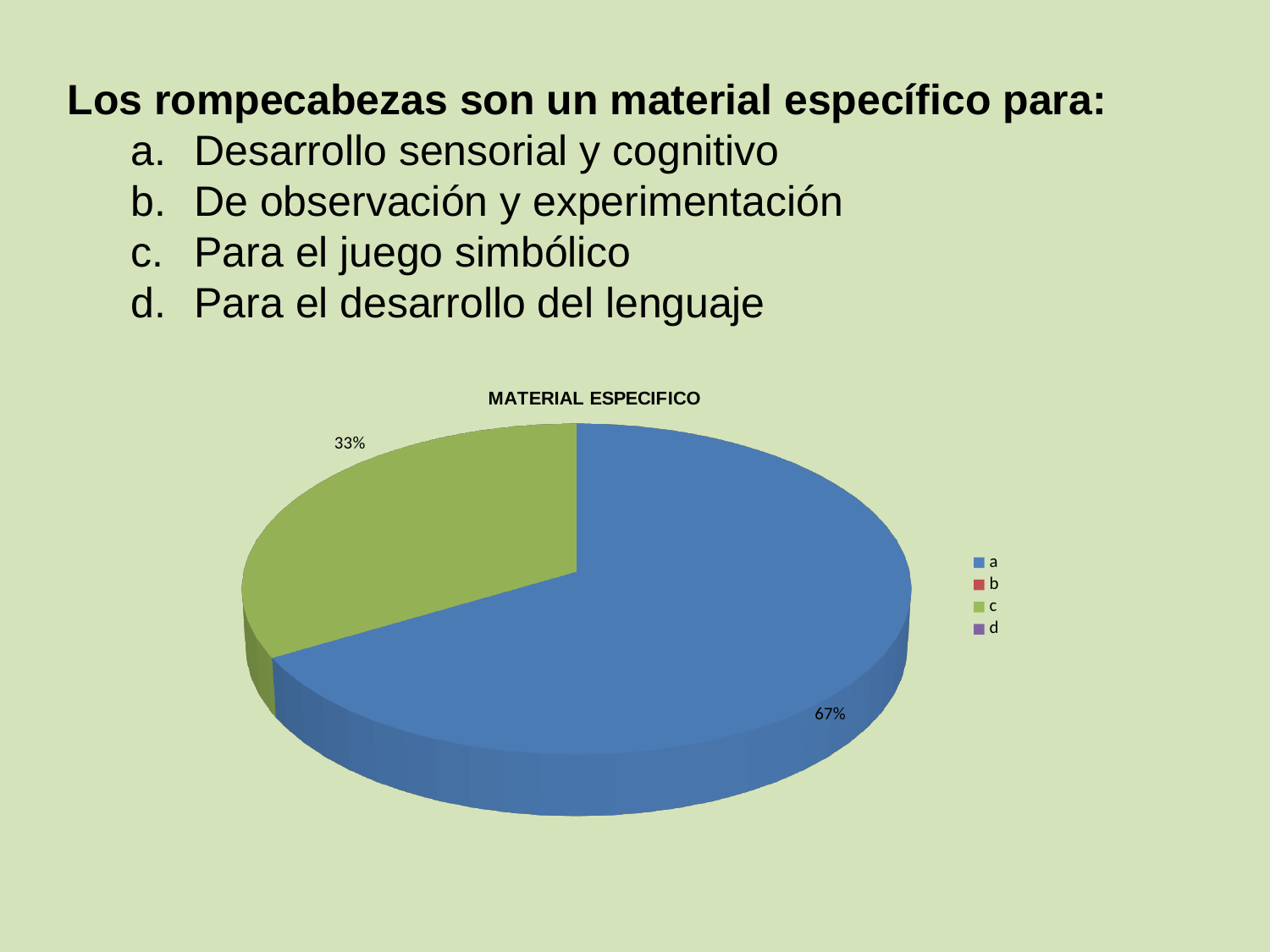
What is the title of the chart? MATERIAL ESPECIFICO How many slices are visible in the pie? 2 Which of the visible slices is smaller, a or c? c How many entries does the legend list? 4 What kind of chart is shown on the slide? pie chart What colour is the slice for category a? blue What share of the pie does category c have? 33% Which category has the largest slice of the pie? a What is the difference in percentage points between the slices for a and c? 34 What share of the pie does category a have? 67% Is the share for category a greater or less than 50%? greater